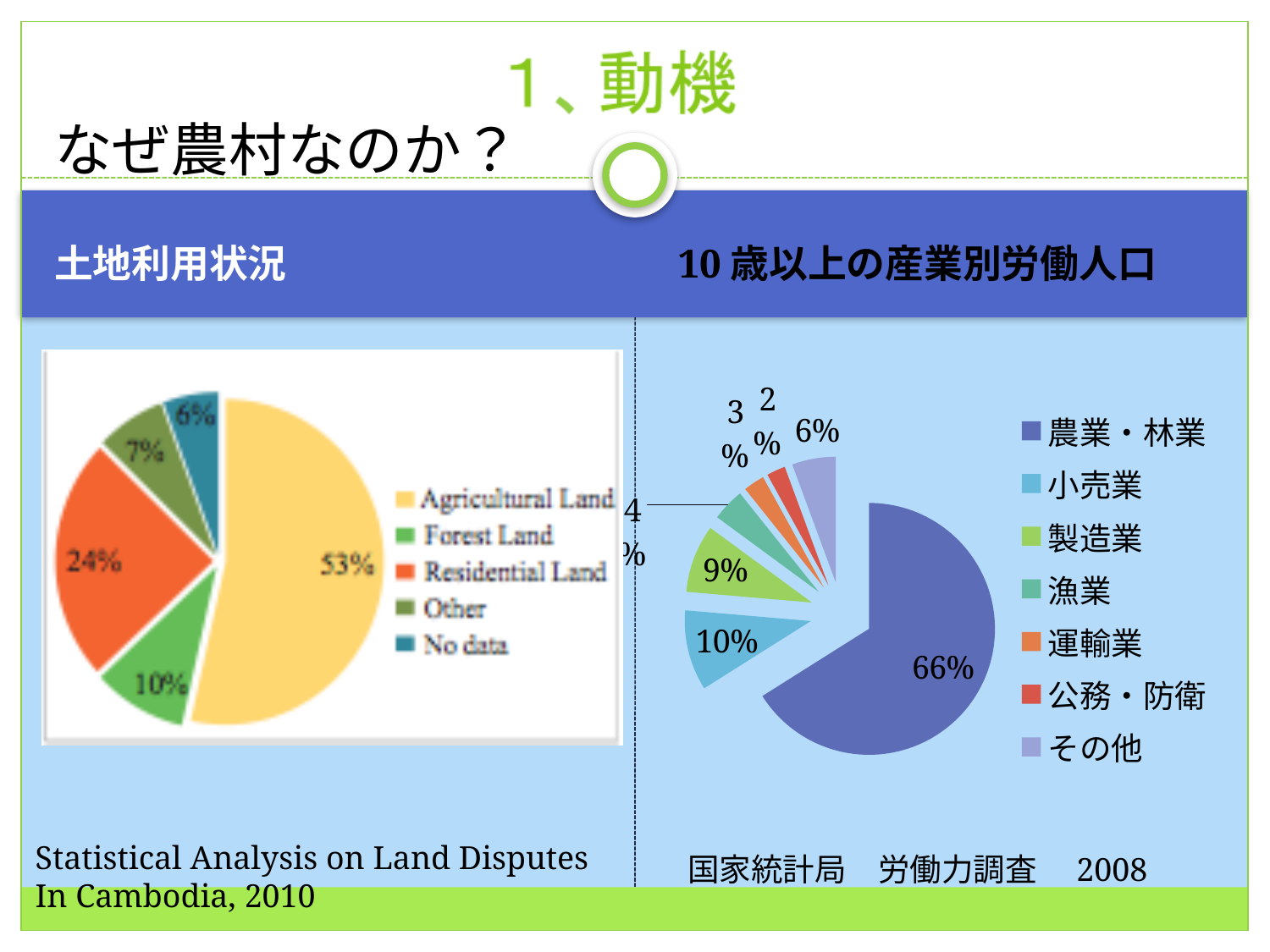
In the left pie chart (土地利用状況), what share is Residential Land? 24% In the right pie chart (10歳以上の産業別労働人口), how many categories does the legend list? 7 In the right pie chart (10歳以上の産業別労働人口), which category has the smallest share? 公務・防衛 In the right pie chart (10歳以上の産業別労働人口), what share is 小売業? 10% In the right pie chart (10歳以上の産業別労働人口), what share is 農業・林業? 66% In the left pie chart (土地利用状況), which category has the smallest share? No data What type of chart is used on the right side of the slide (10歳以上の産業別労働人口)? Pie chart In the left pie chart (土地利用状況), how many categories does the legend list? 5 In the left pie chart (土地利用状況), what share is Agricultural Land? 53% In the left pie chart (土地利用状況), what is the difference between the Agricultural Land share and the Residential Land share? 29% In the right pie chart (10歳以上の産業別労働人口), which is larger, 製造業 or その他? 製造業 In the left pie chart (土地利用状況), which category has the largest share? Agricultural Land